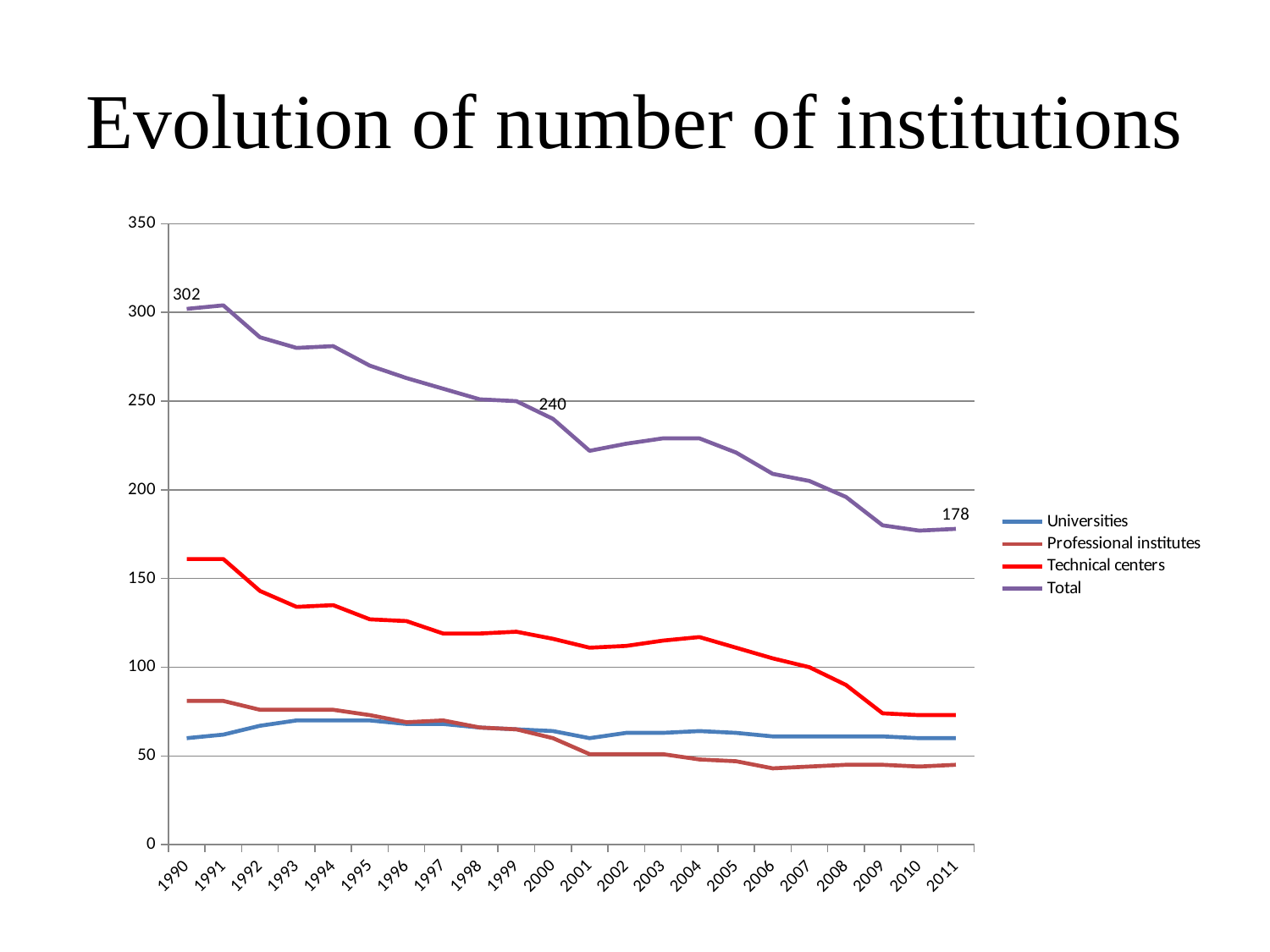
What is the difference between the Total in 1990 and the Total in 2000? 62 What is the Total number of institutions in 2011? 178 What is the Total number of institutions in 1990? 302 What kind of chart is shown on the slide? line chart Is the value for Professional institutes in 2011 greater or less than 50? less Is the value for Technical centers in 1990 greater or less than 150? greater What is the Total number of institutions in 2000? 240 How many series does the legend list? 4 Does the Total series rise or fall from 1990 to 2011? fall By how much did the Total fall from 1990 to 2011? 124 How many years are shown on the x axis? 22 In 2011, which is larger: Technical centers or Universities? Technical centers